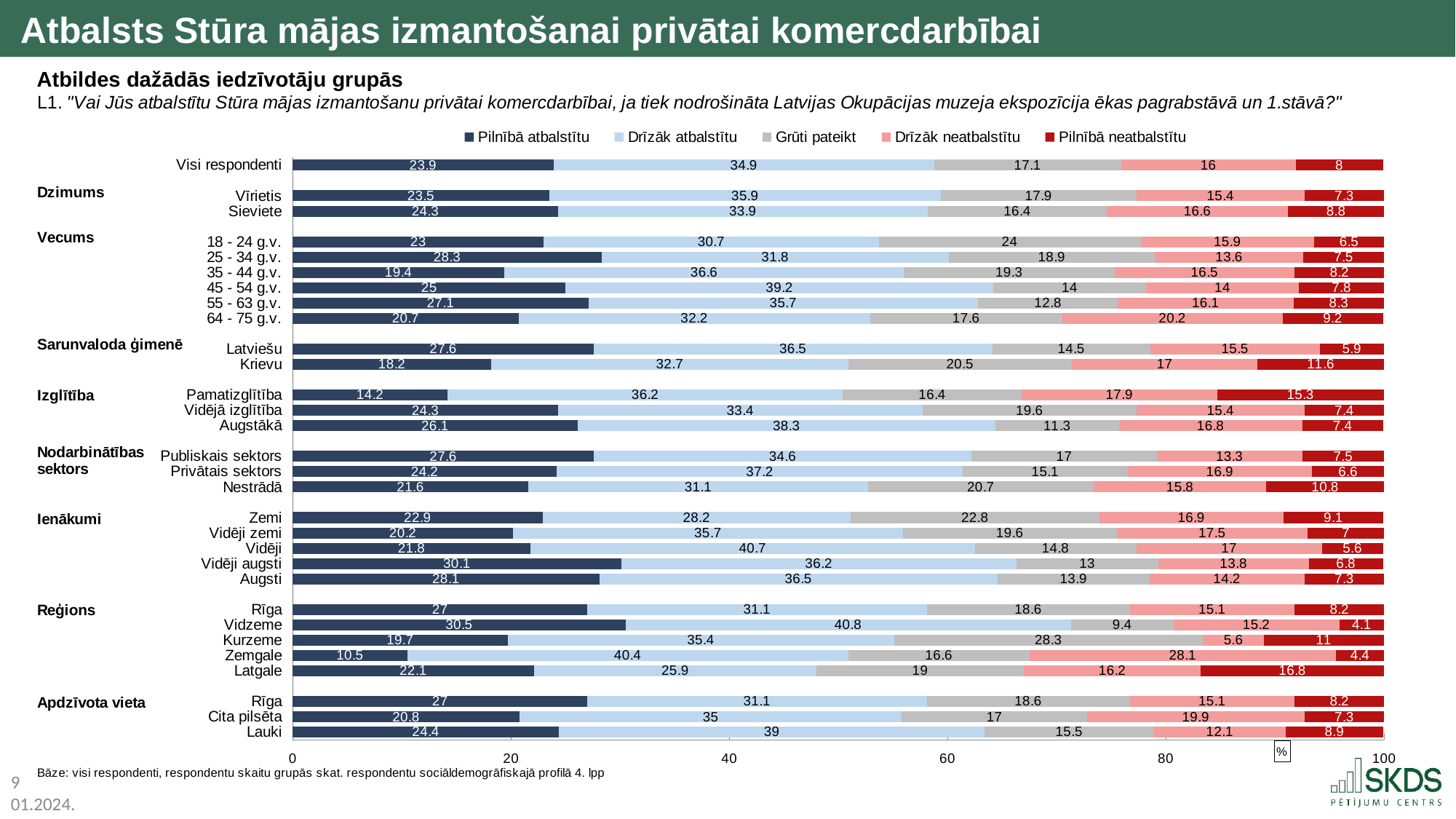
What is the value of "Grūti pateikt" for "Kurzeme"? 28.3 What is the value of "Drīzāk atbalstītu" for "Vidzeme"? 40.8 What is the value of "Pilnībā neatbalstītu" for "Latgale"? 16.8 Which has the larger "Drīzāk atbalstītu" value, "Rīga" or "Latgale"? Rīga What is the difference between the "Pilnībā atbalstītu" values for "Latviešu" and "Krievu"? 9.4 How many series does the legend list? 5 Which group has the lowest value for "Pilnībā atbalstītu"? Zemgale Which group has the highest value for "Pilnībā neatbalstītu"? Latgale What kind of chart is shown on the slide? Stacked bar chart What is the value of "Pilnībā atbalstītu" for "Visi respondenti"? 23.9 What is the total of the stacked bar for "Visi respondenti"? 99.9 What is the first entry in the chart legend? Pilnībā atbalstītu